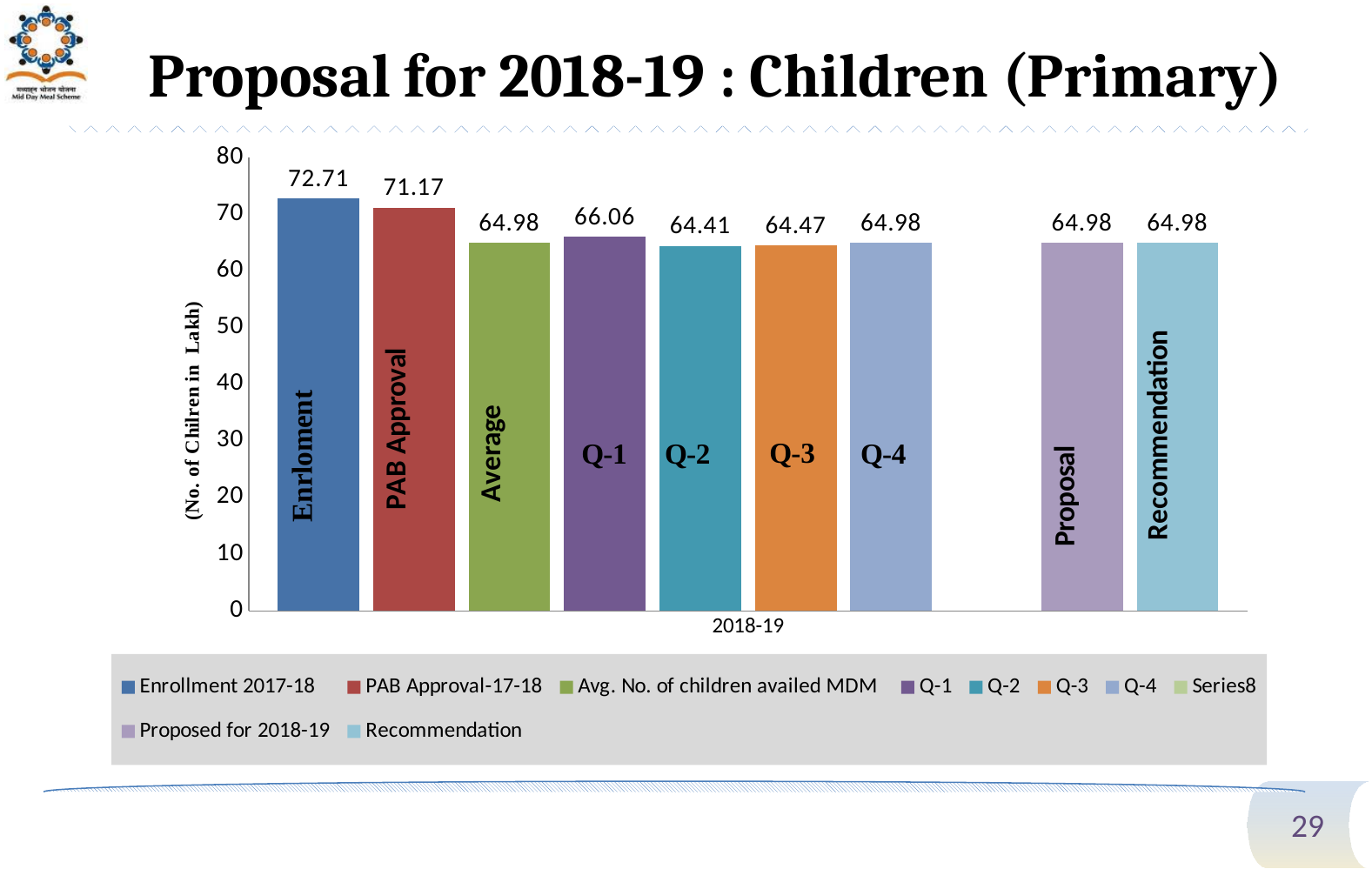
What type of chart is shown on the slide? Bar chart Which bar has the highest value? Enrolment Which is larger, the Q-1 value or the Q-3 value? Q-1 What is the value shown for PAB Approval? 71.17 What is the value of the Q-1 bar? 66.06 What is the value shown for Q-2? 64.41 How many bars are plotted in the chart? 9 Which bar has the lowest value? Q-2 What is the y-axis label of the chart? (No. of Chilren in Lakh) What is the value of the Enrolment bar? 72.71 What is the value of the Proposal bar? 64.98 What is the difference between the Enrolment value and the PAB Approval value? 1.54